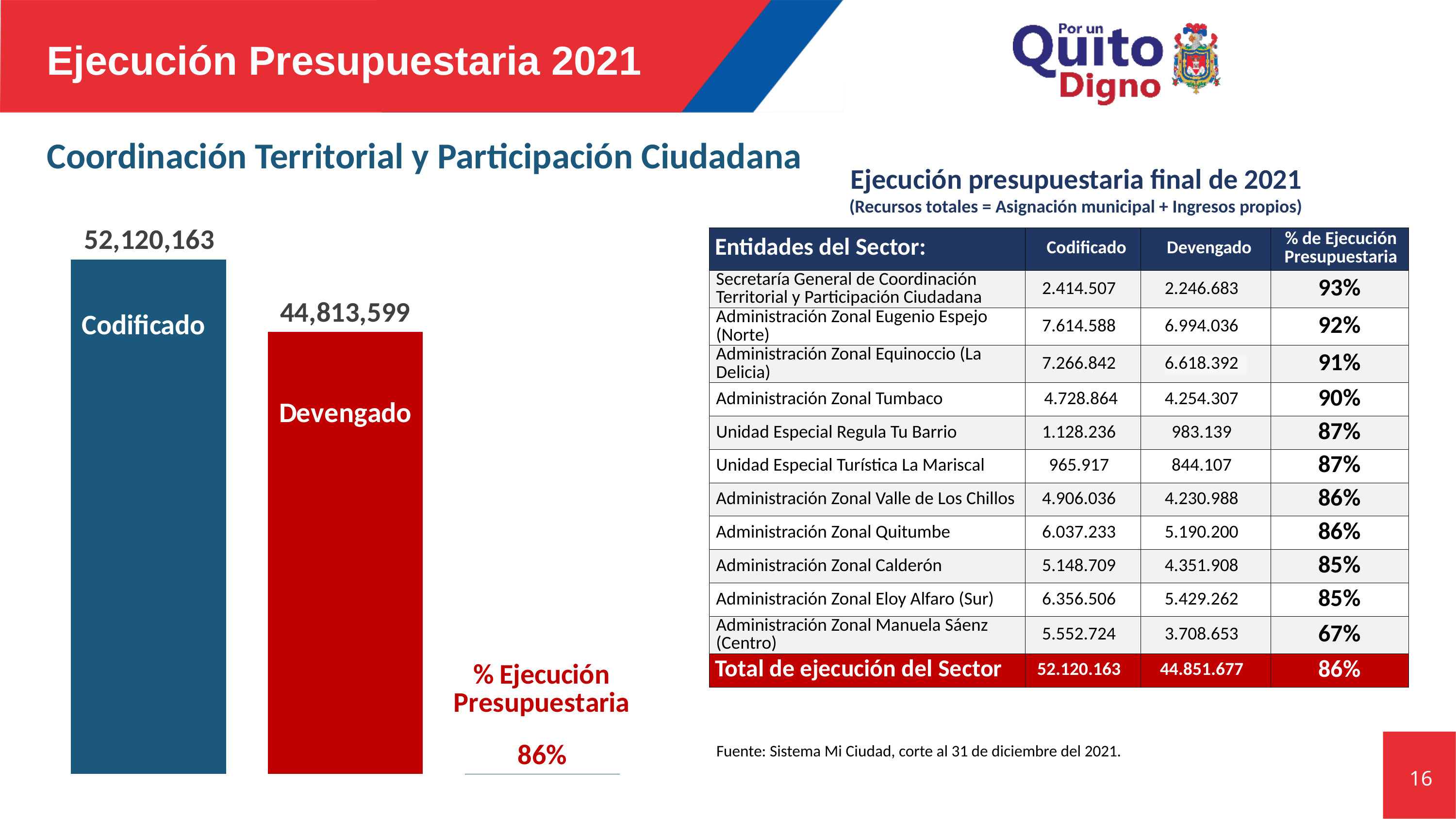
What % Ejecución Presupuestaria is shown next to the chart? 86% What kind of chart is shown on the left of the slide? Bar chart Which is larger in the chart, Codificado or Devengado? Codificado What colour is the Codificado bar in the chart? Blue How many bars are shown in the chart? 2 What colour is the Devengado bar in the chart? Red Which bar in the chart is the lowest? Devengado What is the value of the Devengado bar in the chart? 44,813,599 What is the difference between the Codificado and Devengado values in the chart? 7,306,564 What is the value of the Codificado bar in the chart? 52,120,163 Which bar in the chart is the highest? Codificado